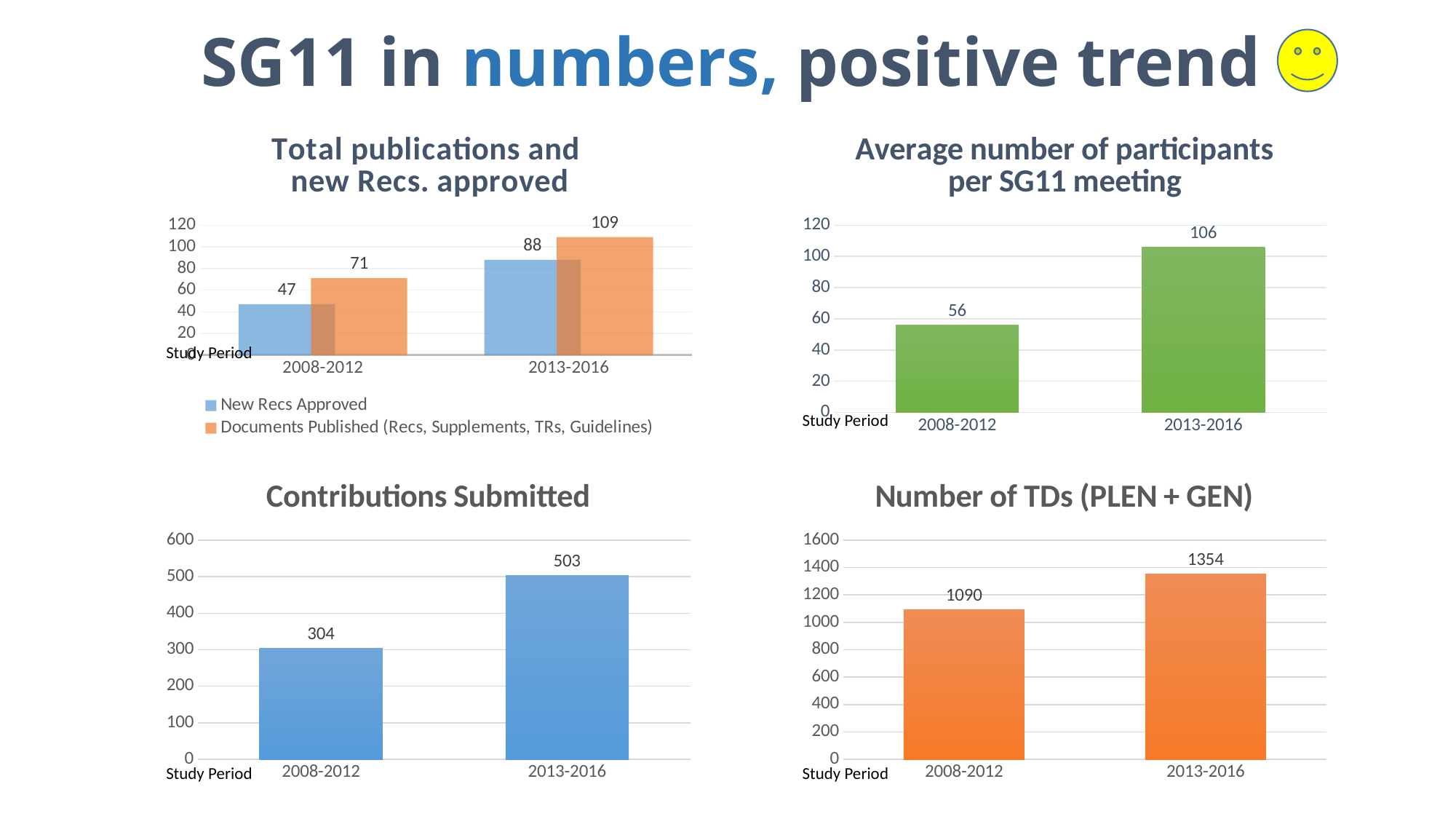
In the 'Number of TDs (PLEN + GEN)' chart, what is the value for 2013-2016? 1354 In the 'Total publications and new Recs. approved' chart, what is the difference between Documents Published and New Recs Approved in 2013-2016? 21 In the 'Total publications and new Recs. approved' chart, what is the value for Documents Published in 2013-2016? 109 In the 'Average number of participants per SG11 meeting' chart, what is the difference between 2013-2016 and 2008-2012? 50 In the 'Total publications and new Recs. approved' chart, how many series does the legend list? 2 In the 'Average number of participants per SG11 meeting' chart, what is the value for 2013-2016? 106 In the 'Contributions Submitted' chart, what is the value for 2008-2012? 304 In the 'Average number of participants per SG11 meeting' chart, which study period has the lowest value? 2008-2012 In the 'Contributions Submitted' chart, do the values rise or fall from 2008-2012 to 2013-2016? rise In the 'Number of TDs (PLEN + GEN)' chart, what is the difference between 2013-2016 and 2008-2012? 264 What kind of chart is the 'Contributions Submitted' chart? bar chart In the 'Total publications and new Recs. approved' chart, what is the value for New Recs Approved in 2008-2012? 47